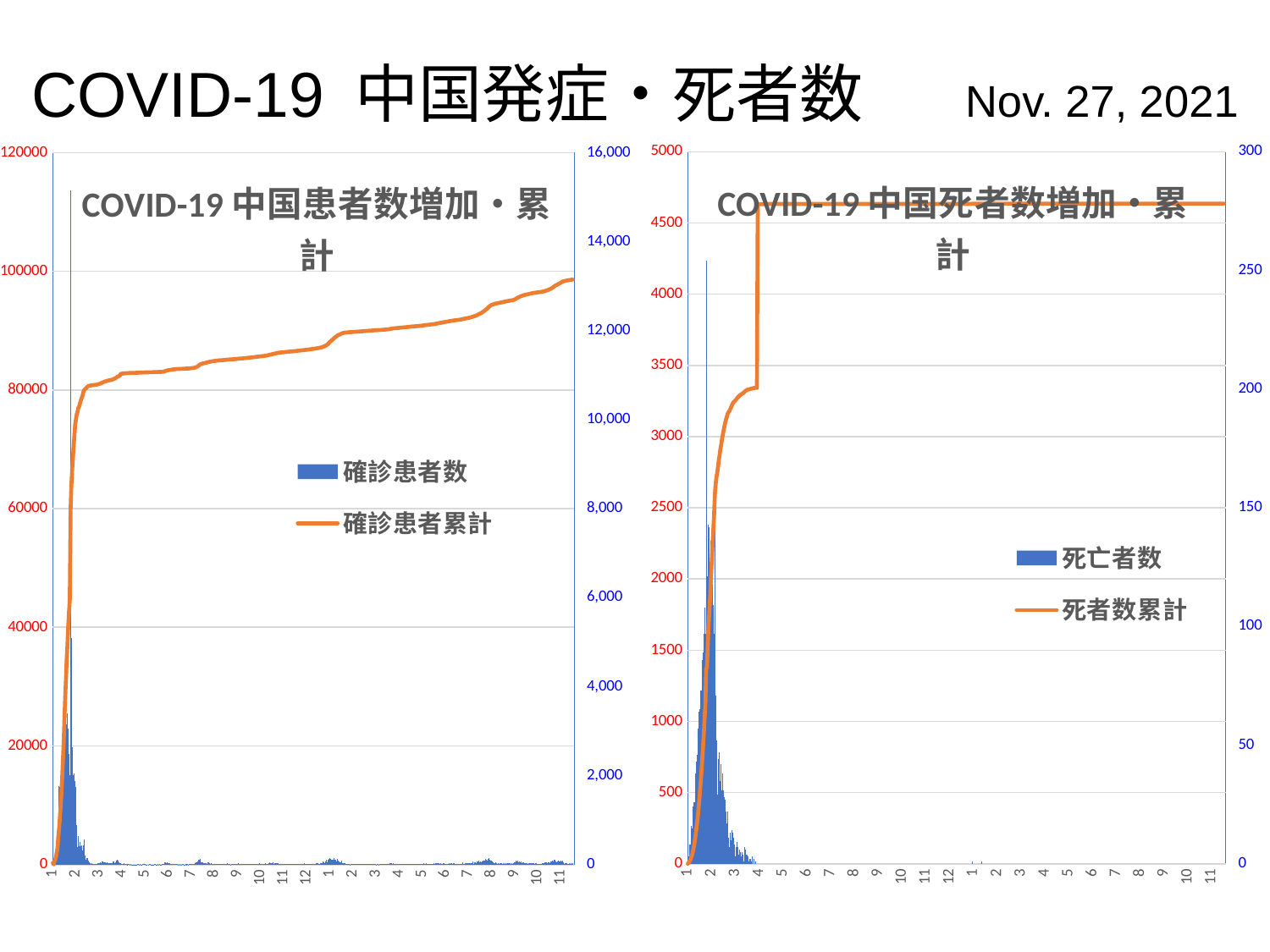
In the left chart (COVID-19 中国患者数増加・累計), how many series does the legend list? 2 In the left chart (COVID-19 中国患者数増加・累計), is the final value of the 確診患者累計 line greater or less than 80000 on the left axis? greater In the right chart (COVID-19 中国死者数増加・累計), is the plateau value of the 死者数累計 line greater or less than 4000 on the left axis? greater What kind of chart is the right chart (COVID-19 中国死者数増加・累計)? Combined bar and line chart In the left chart (COVID-19 中国患者数増加・累計), which series is drawn as bars? 確診患者数 In the left chart (COVID-19 中国患者数増加・累計), does the orange 確診患者累計 line rise or fall along the x axis? Rise What is the title of the chart on the left side of the slide? COVID-19 中国患者数増加・累計 In the right chart (COVID-19 中国死者数増加・累計), does the orange 死者数累計 line rise or fall overall along the x axis? Rise In the right chart (COVID-19 中国死者数増加・累計), how many series does the legend list? 2 What kind of chart is the left chart (COVID-19 中国患者数増加・累計)? Combined bar and line chart What is the title of the chart on the right side of the slide? COVID-19 中国死者数増加・累計 How many charts are shown on the slide? 2